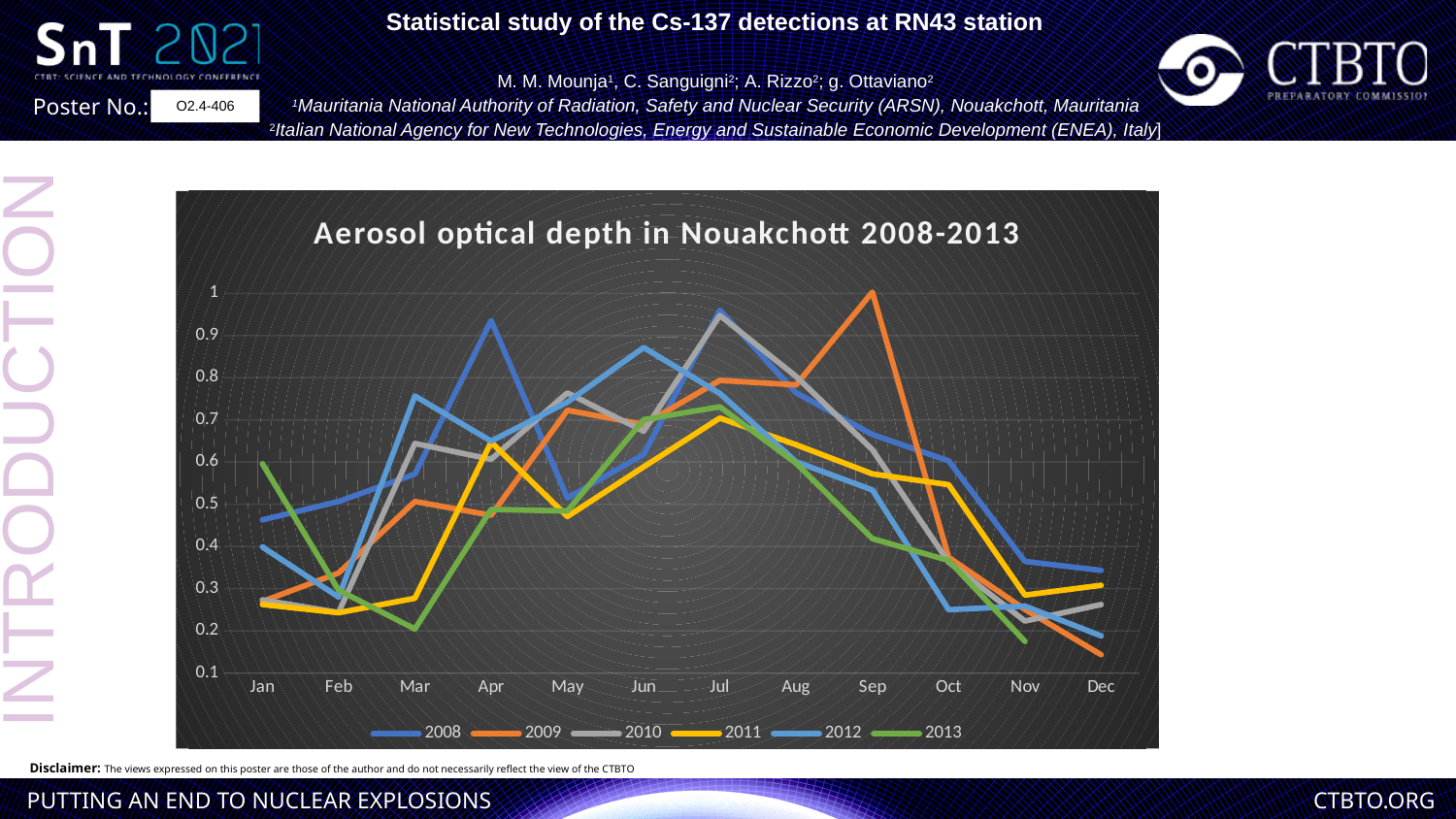
How many series does the legend list? 6 What is the title of the chart? Aerosol optical depth in Nouakchott 2008-2013 What kind of chart is shown on the slide? line chart How many months are shown along the x axis? 12 In which month does the 2009 series reach its lowest value? Dec In which month does the 2009 series reach its highest value? Sep Is the value for 2013 in Mar greater or less than 0.3? less Is the value for 2008 in Jul greater or less than 0.9? greater Does the 2009 series rise or fall from Sep to Dec? fall In Jan, which series has the larger value, 2013 or 2009? 2013 In which month does the 2012 series reach its highest value? Jun Is the value for 2009 in Sep greater or less than 0.9? greater